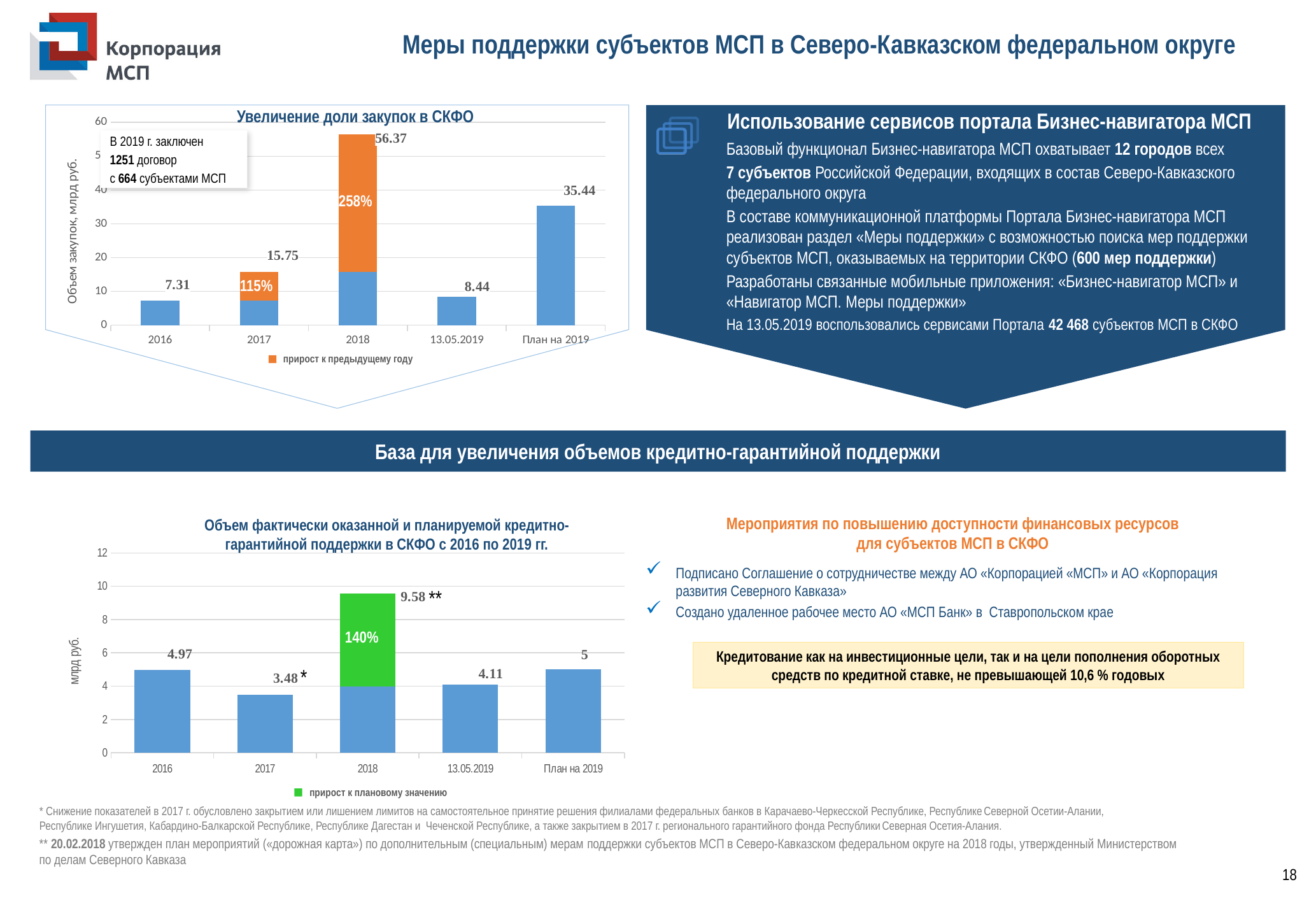
In the chart 'Увеличение доли закупок в СКФО', which category has the lowest value? 2016 In the bottom chart on credit-guarantee support in СКФО, what is the value for 2016? 4.97 In the chart 'Увеличение доли закупок в СКФО', what growth percentage is shown on the 2017 bar? 115% What type of chart is the bottom chart on credit-guarantee support in СКФО? bar chart In the bottom chart on credit-guarantee support in СКФО, which category has the highest value? 2018 In the chart 'Увеличение доли закупок в СКФО', how many categories are shown on the x axis? 5 In the bottom chart on credit-guarantee support in СКФО, what does the green legend entry say? прирост к плановому значению In the bottom chart on credit-guarantee support in СКФО, is the value for 13.05.2019 greater or less than 2016? less In the chart 'Увеличение доли закупок в СКФО', what is the difference between the 2018 value and the 'План на 2019' value? 20.93 In the chart 'Увеличение доли закупок в СКФО', what is the value for 'План на 2019'? 35.44 In the chart 'Увеличение доли закупок в СКФО', what is the value for 2018? 56.37 In the bottom chart on credit-guarantee support in СКФО, what is the difference between the 2016 and 2017 values? 1.49